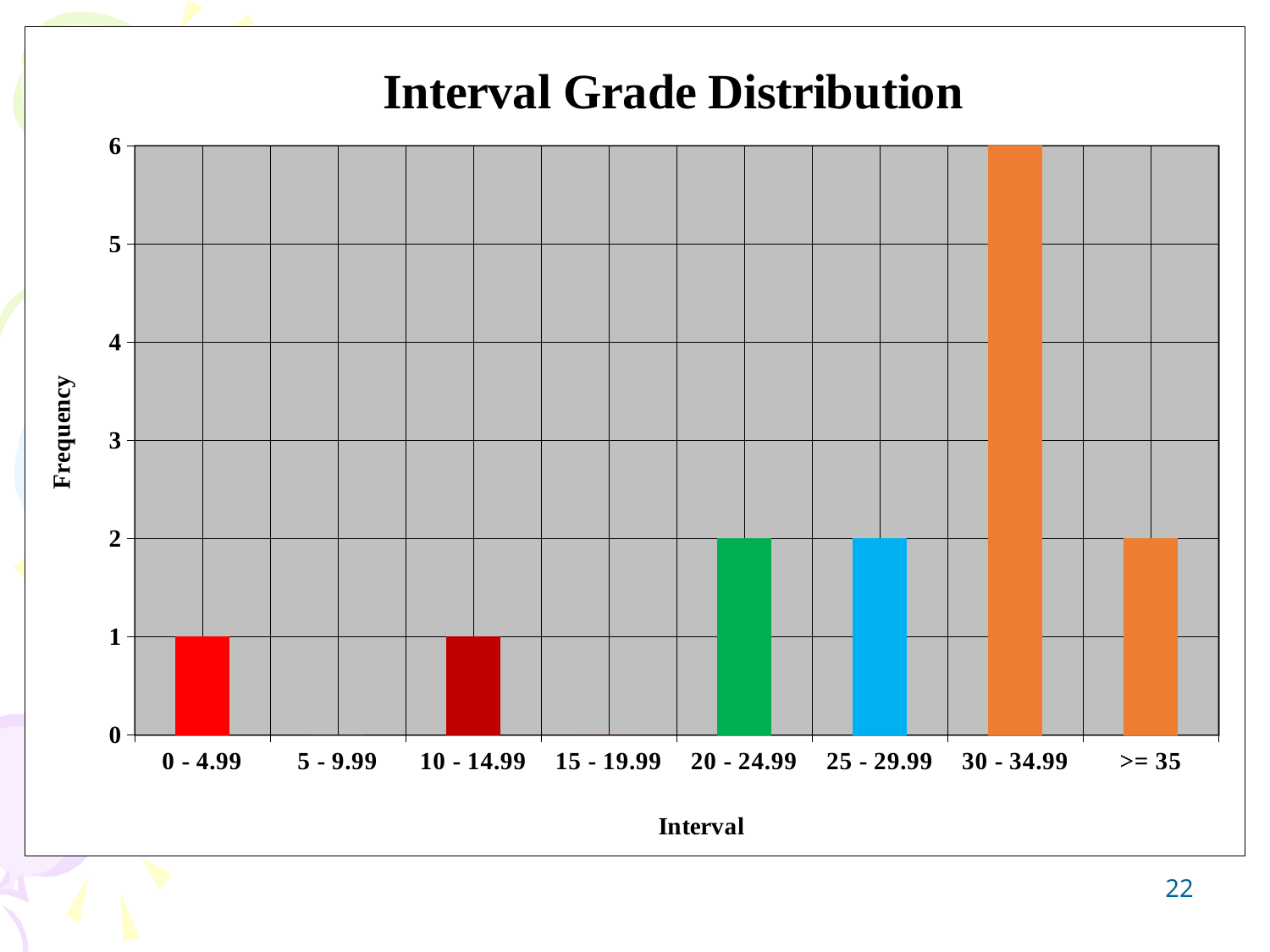
What is the frequency for the interval >= 35? 2 What type of chart is shown on the slide? bar chart What is the title of the chart? Interval Grade Distribution What is the label of the y axis? Frequency Is the frequency for the 30 - 34.99 interval greater or less than 4? greater What is the frequency for the interval 30 - 34.99? 6 How many intervals are shown on the x axis? 8 Which has a higher frequency, the 10 - 14.99 interval or the 20 - 24.99 interval? 20 - 24.99 What is the frequency for the interval 0 - 4.99? 1 What is the difference in frequency between the 30 - 34.99 interval and the 25 - 29.99 interval? 4 What is the frequency for the interval 20 - 24.99? 2 Which interval has the highest frequency? 30 - 34.99